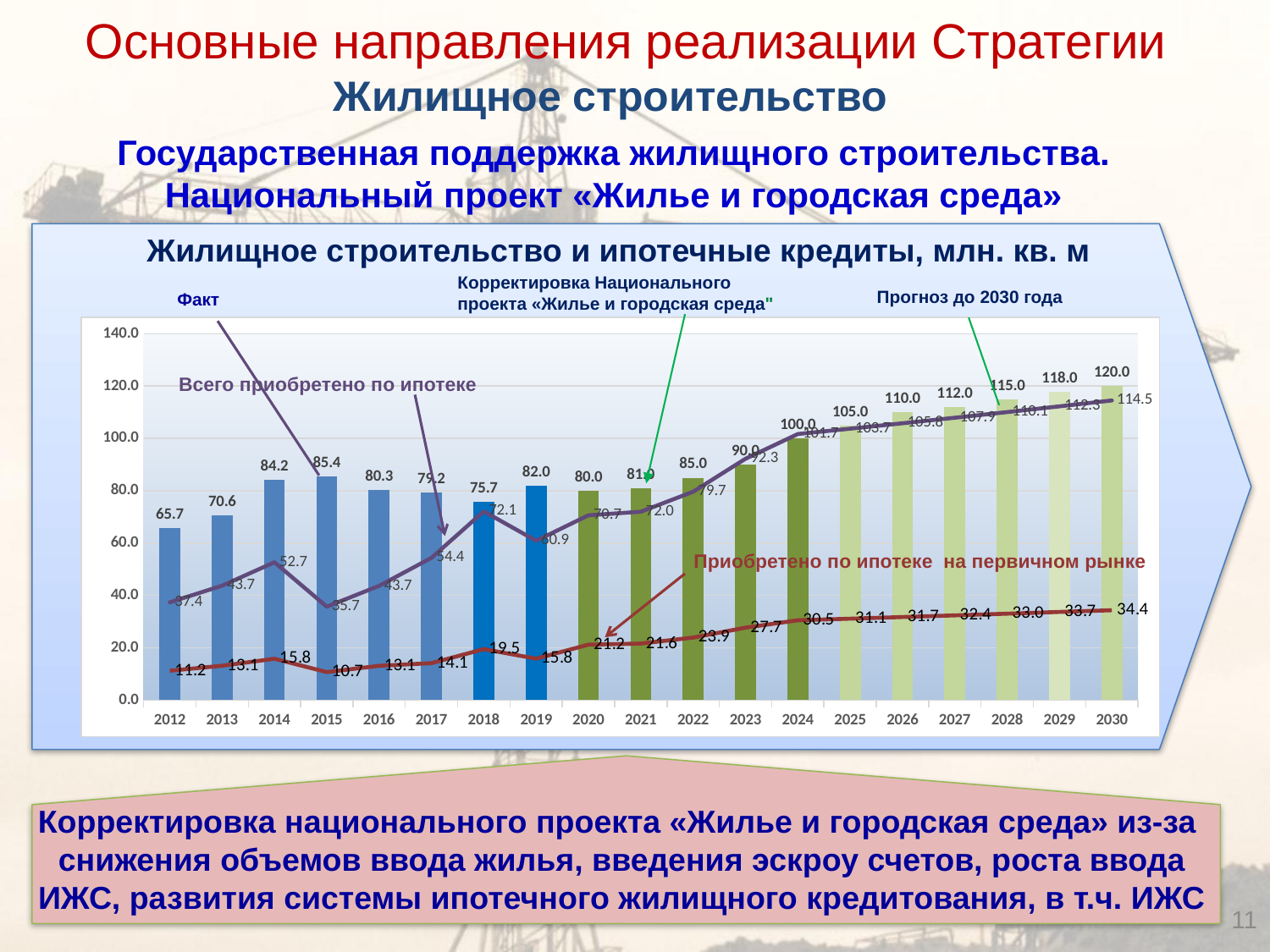
Which bar is taller, 2014 or 2015? 2015 Do the values of the line 'Приобретено по ипотеке на первичном рынке' generally rise or fall from 2020 to 2030? rise How many years are shown on the x axis? 19 What is the value of the bar for 2030? 120.0 What is the difference between the bar values for 2030 and 2012? 54.3 Which year has the lowest bar? 2012 What is the value of the bar for 2024? 100.0 What is the value of the bar for 2012? 65.7 Which year has the highest bar? 2030 What is the title of the chart? Жилищное строительство и ипотечные кредиты, млн. кв. м What is the value of the line 'Всего приобретено по ипотеке' for 2012? 37.4 What is the value of the line 'Приобретено по ипотеке на первичном рынке' for 2030? 34.4